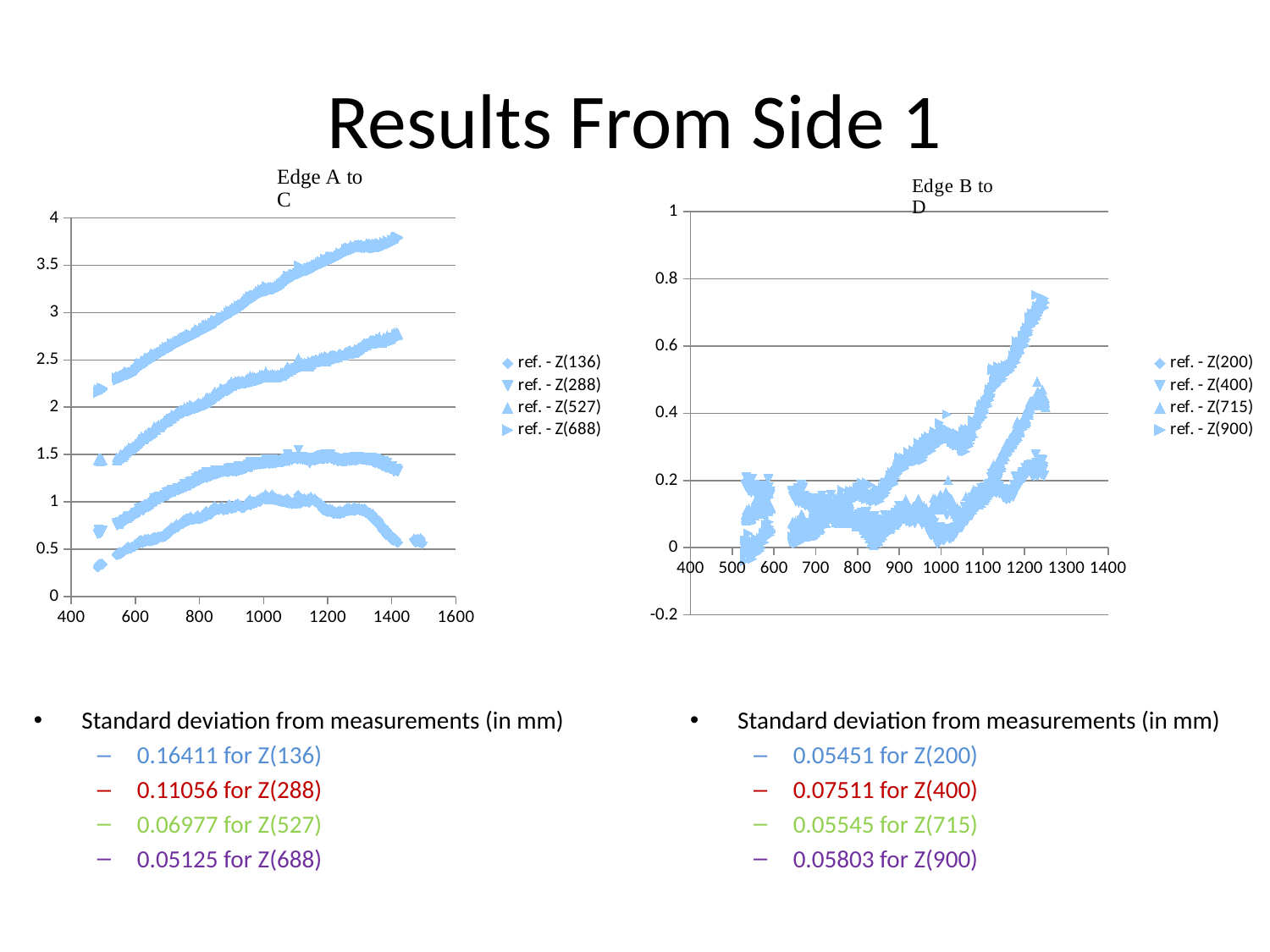
In the 'Edge B to D' chart, do the plotted values generally rise or fall between x = 1000 and x = 1200? rise What kind of chart is the 'Edge A to C' chart? Scatter chart What is the title of the chart on the left of the slide? Edge A to C In the 'Edge B to D' chart, is the highest plotted value greater or less than 0.6? greater What kind of chart is the 'Edge B to D' chart? Scatter chart How many series does the legend of the 'Edge A to C' chart list? 4 In the 'Edge A to C' chart, is the highest plotted value greater or less than 3.5? greater In the 'Edge A to C' chart, is the lowest plotted value greater or less than 0.5? less Which series are listed in the legend of the 'Edge B to D' chart? ref. - Z(200), ref. - Z(400), ref. - Z(715), ref. - Z(900) How many series does the legend of the 'Edge B to D' chart list? 4 In the 'Edge A to C' chart, does the topmost series rise or fall as the x value increases? rise